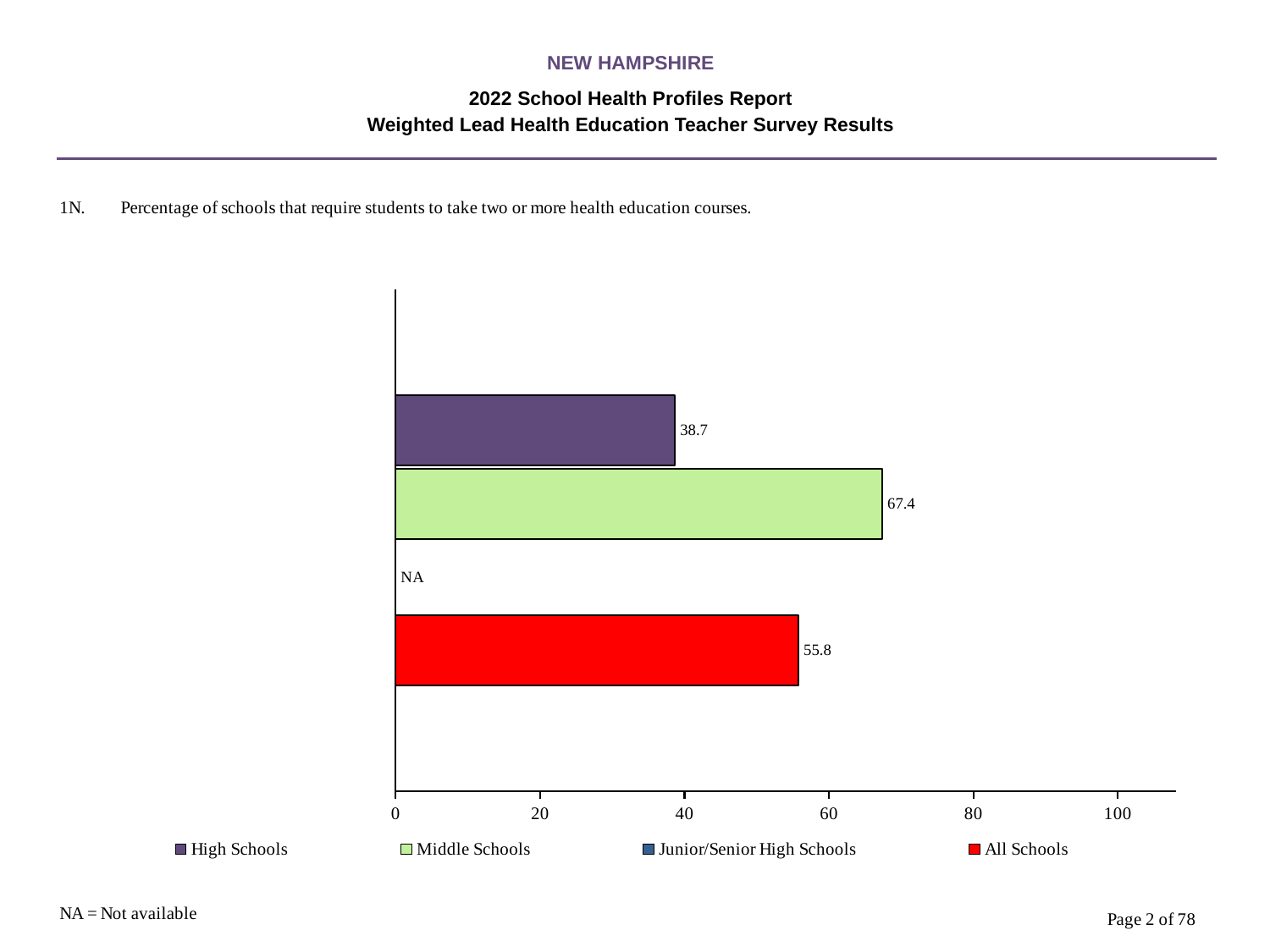
What kind of chart is shown? bar chart What is the value for Middle Schools? 67.4 What is the difference between the Middle Schools value and the High Schools value? 28.7 What is shown for Junior/Senior High Schools? NA Is the value for Middle Schools greater or less than 60? greater What does NA stand for on the slide? Not available What is the value for All Schools? 55.8 Which school type with a plotted value has the lowest value? High Schools Which is larger, the value for All Schools or the value for High Schools? All Schools What is the value for High Schools? 38.7 How many series does the legend list? 4 Which school type has the highest value? Middle Schools